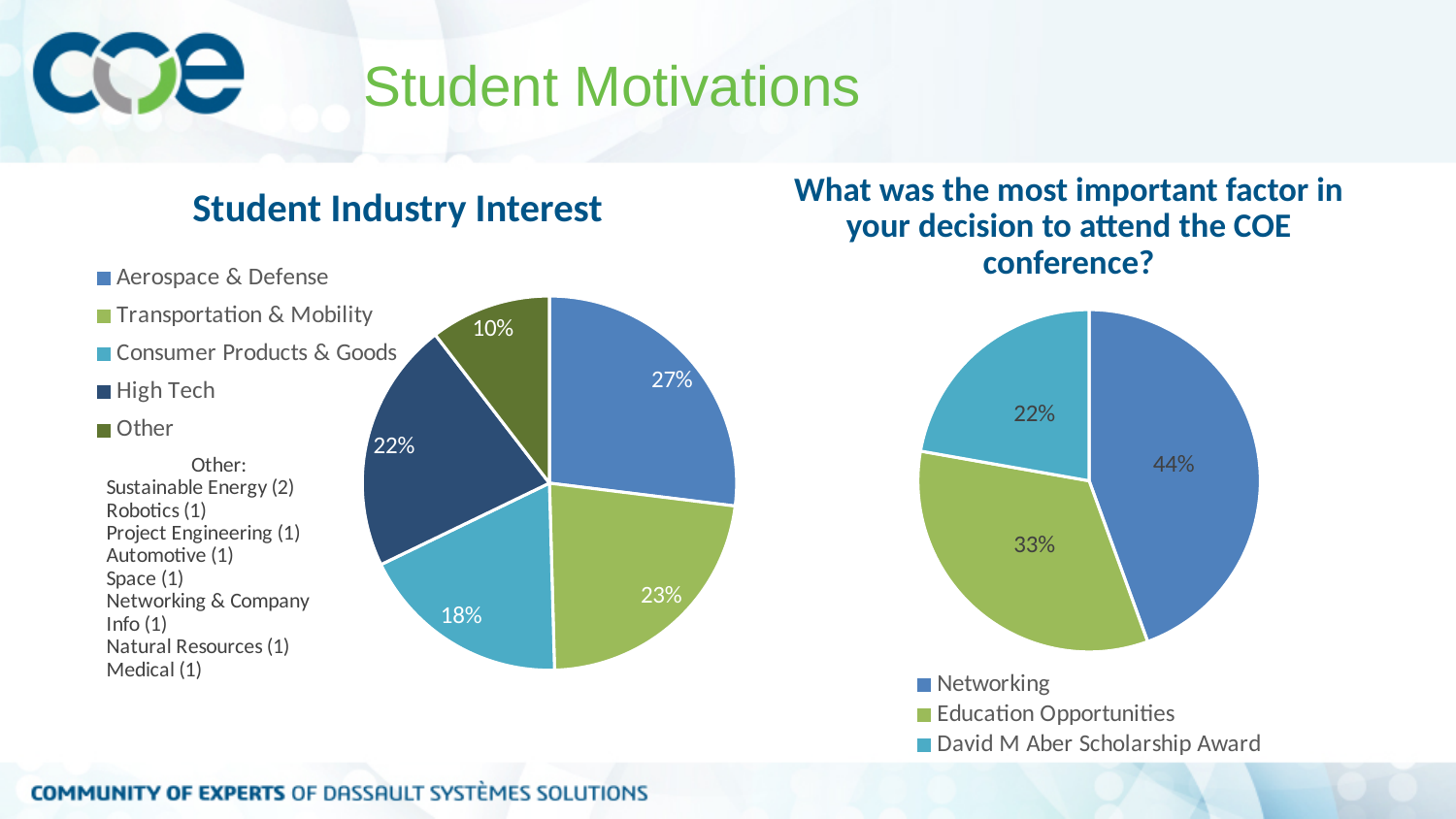
In the Student Industry Interest chart, which category has the smallest share? Other What type of chart is used for the chart on the right side of the slide? Pie chart In the chart on the right, which is larger: Education Opportunities or David M Aber Scholarship Award? Education Opportunities In the chart titled 'What was the most important factor in your decision to attend the COE conference?', which factor has the largest share? Networking In the Student Industry Interest chart, what is the difference between the Transportation & Mobility share and the High Tech share? 1% In the chart titled 'What was the most important factor in your decision to attend the COE conference?', what share is the David M Aber Scholarship Award? 22% In the chart titled 'What was the most important factor in your decision to attend the COE conference?', what share is Networking? 44% In the Student Industry Interest chart, which category has the largest share? Aerospace & Defense In the chart titled 'What was the most important factor in your decision to attend the COE conference?', what is the difference between Networking and Education Opportunities? 11% In the Student Industry Interest chart, what share is Consumer Products & Goods? 18% In the Student Industry Interest chart, how many categories does the legend list? 5 In the Student Industry Interest chart, what share is Aerospace & Defense? 27%